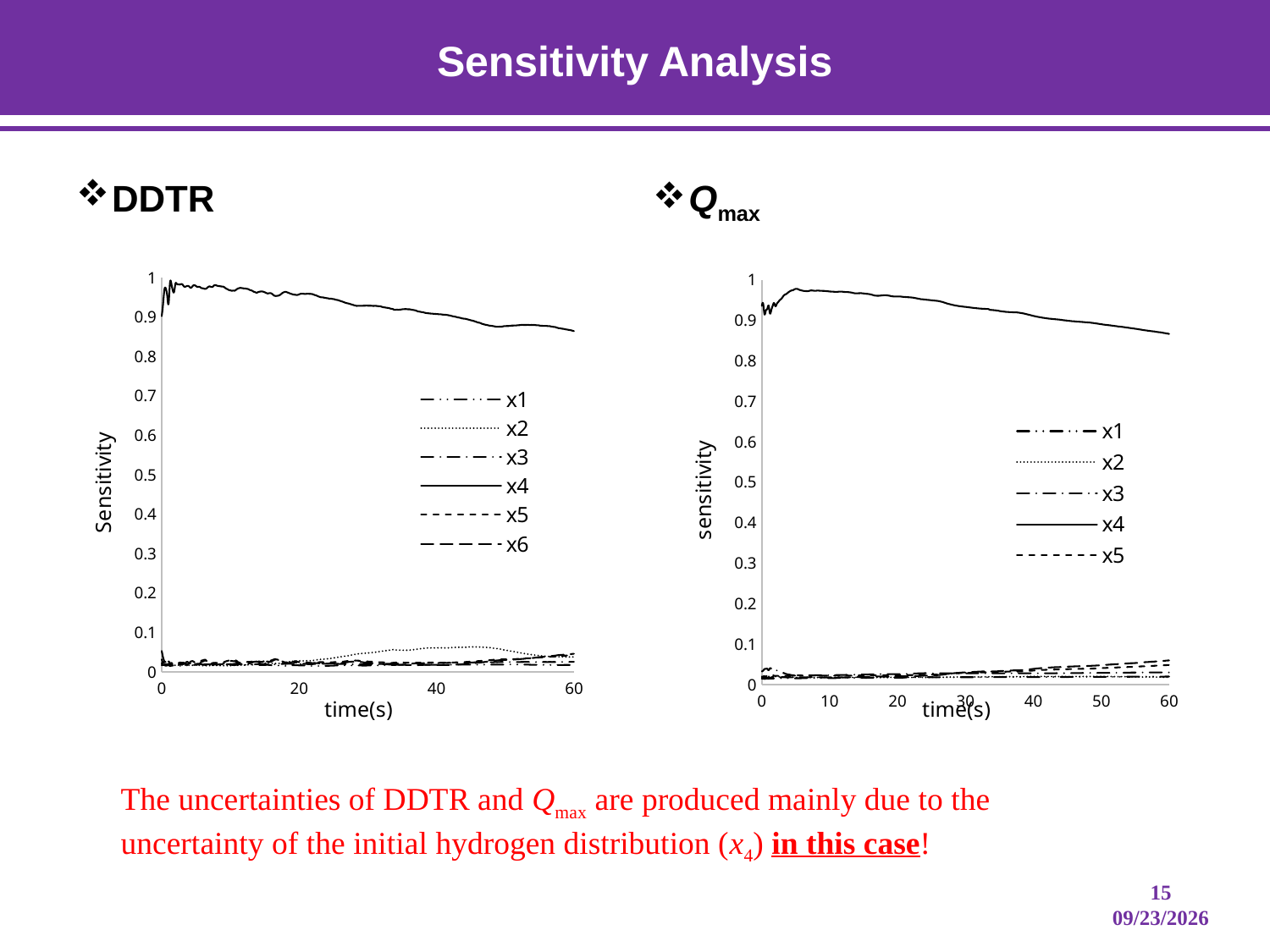
In the DDTR chart, is the sensitivity of x4 at 60 s greater or less than 0.8? greater In the Qmax chart, does the sensitivity of x4 rise or fall between 10 s and 60 s? fall In the DDTR chart, which series has the highest sensitivity across the time range? x4 In the Qmax chart, which series has the highest sensitivity across the time range? x4 What kind of chart is the DDTR chart on the left? line chart How many series does the legend of the DDTR chart list? 6 In the DDTR chart, does the sensitivity of x4 rise or fall between 20 s and 60 s? fall In the DDTR chart at 40 s, which series has the larger sensitivity, x4 or x2? x4 Which series appears in the DDTR chart legend but not in the Qmax chart legend? x6 How many series does the legend of the Qmax chart list? 5 What is the x-axis label of the Qmax chart? time(s) In the Qmax chart, is the sensitivity of x2 at 40 s greater or less than 0.1? less